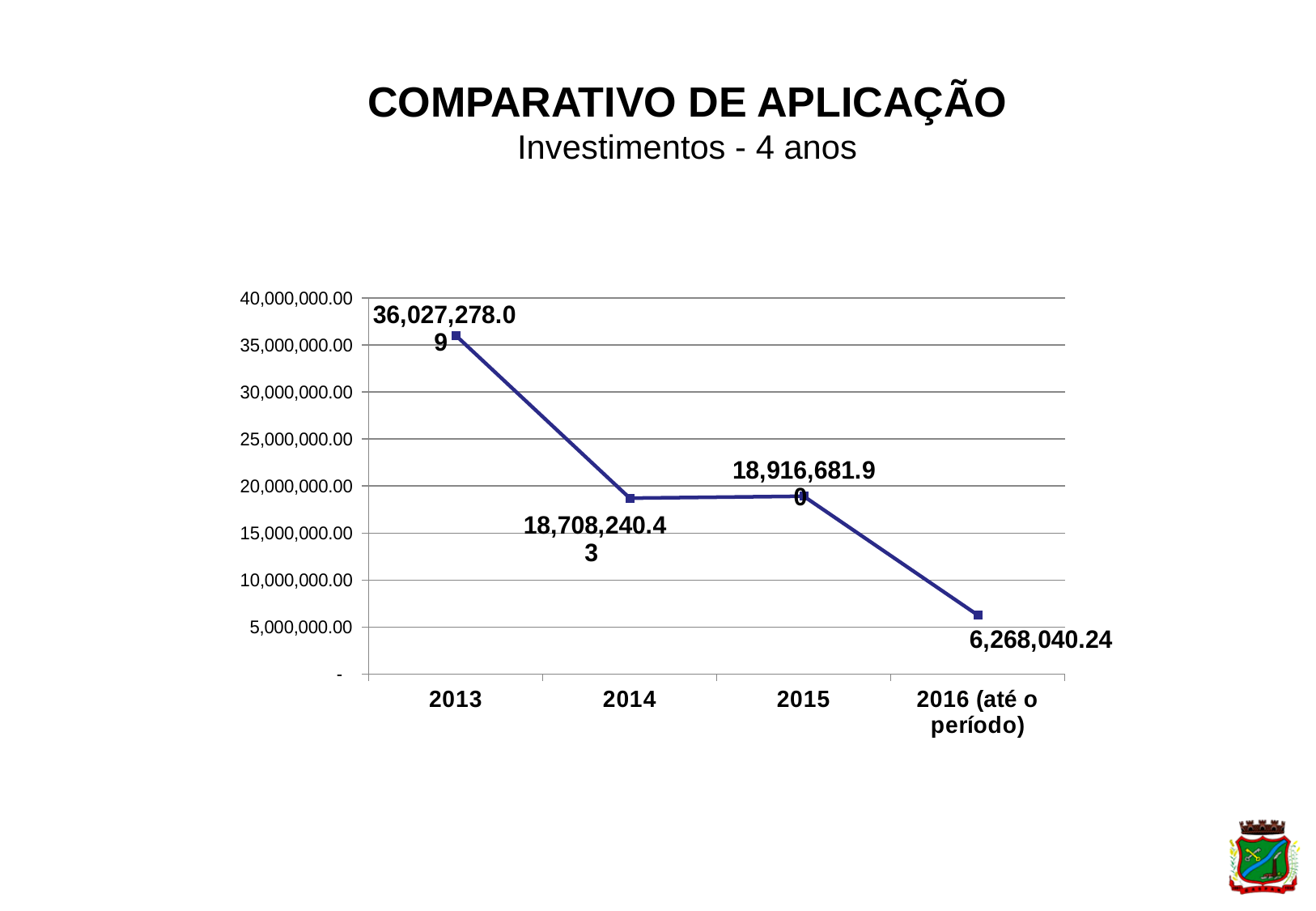
What is the value for 2014? 18,708,240.43 What kind of chart is shown on the slide? line chart What is the value for 2016 (até o período)? 6,268,040.24 What is the difference between the values for 2013 and 2014? 17,319,037.66 What is the value for 2015? 18,916,681.90 Which is larger, the value for 2014 or the value for 2015? 2015 What is the value for 2013? 36,027,278.09 Which year has the highest value? 2013 Is the value for 2016 (até o período) greater or less than 10,000,000.00? less What is the difference between the values for 2015 and 2016 (até o período)? 12,648,641.66 How many data points are plotted on the chart? 4 Which category has the lowest value? 2016 (até o período)